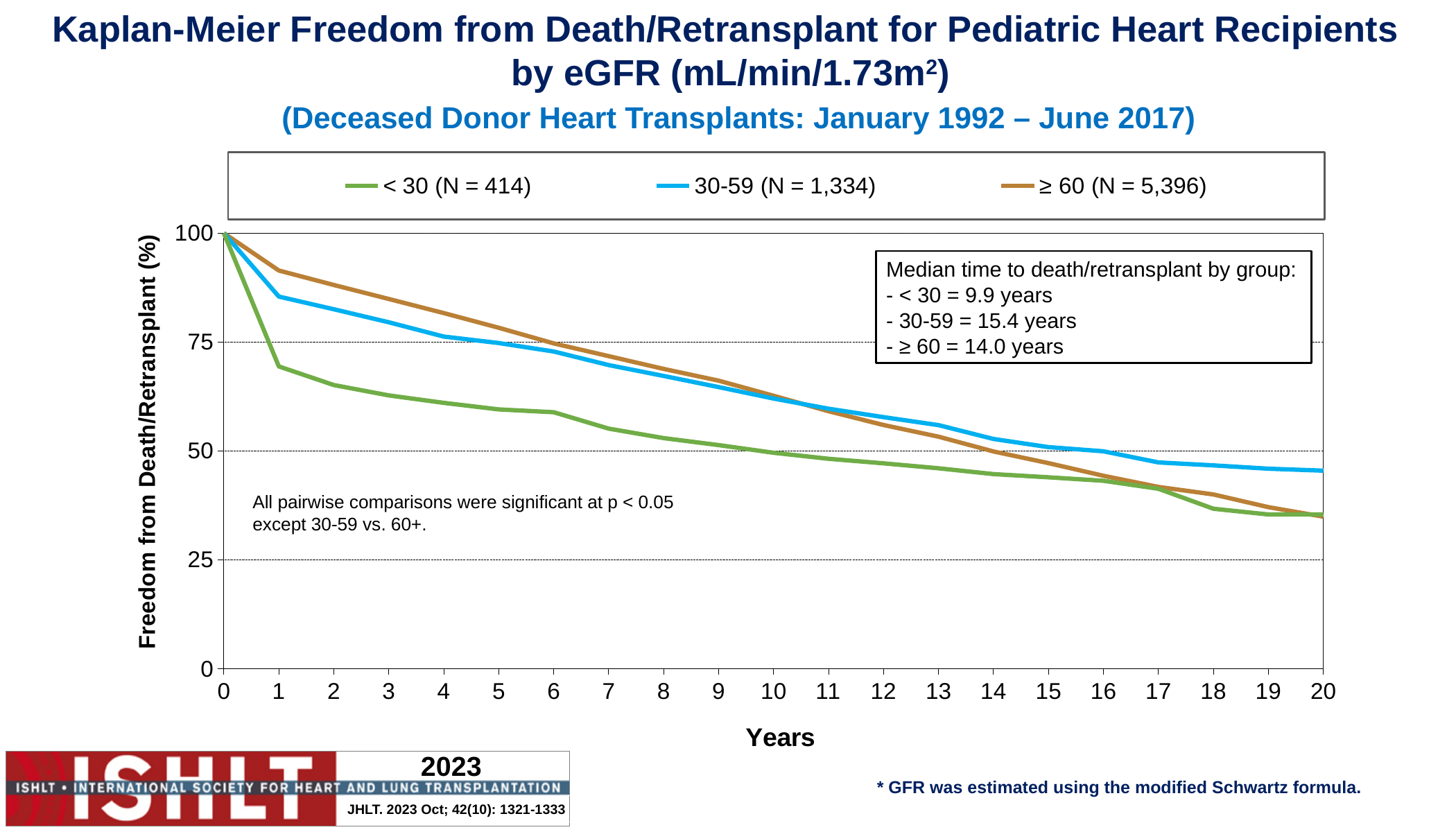
Do the values for the < 30 group rise or fall as years increase? fall Is the value for the ≥ 60 group at year 10 greater or less than 50? greater How many series does the legend list? 3 What is the freedom from death/retransplant for all three groups at year 0? 100 Is the value for the 30-59 group at year 20 greater or less than 50? less What kind of chart is shown on the slide? line chart At year 5, which group has the higher freedom from death/retransplant, < 30 or ≥ 60? ≥ 60 Is the value for the 30-59 group at year 1 greater or less than 75? greater According to the text box, what is the median time to death/retransplant for the 30-59 group? 15.4 years What is the N shown in the legend for the ≥ 60 group? 5,396 At year 20, which group has the higher freedom from death/retransplant, 30-59 or ≥ 60? 30-59